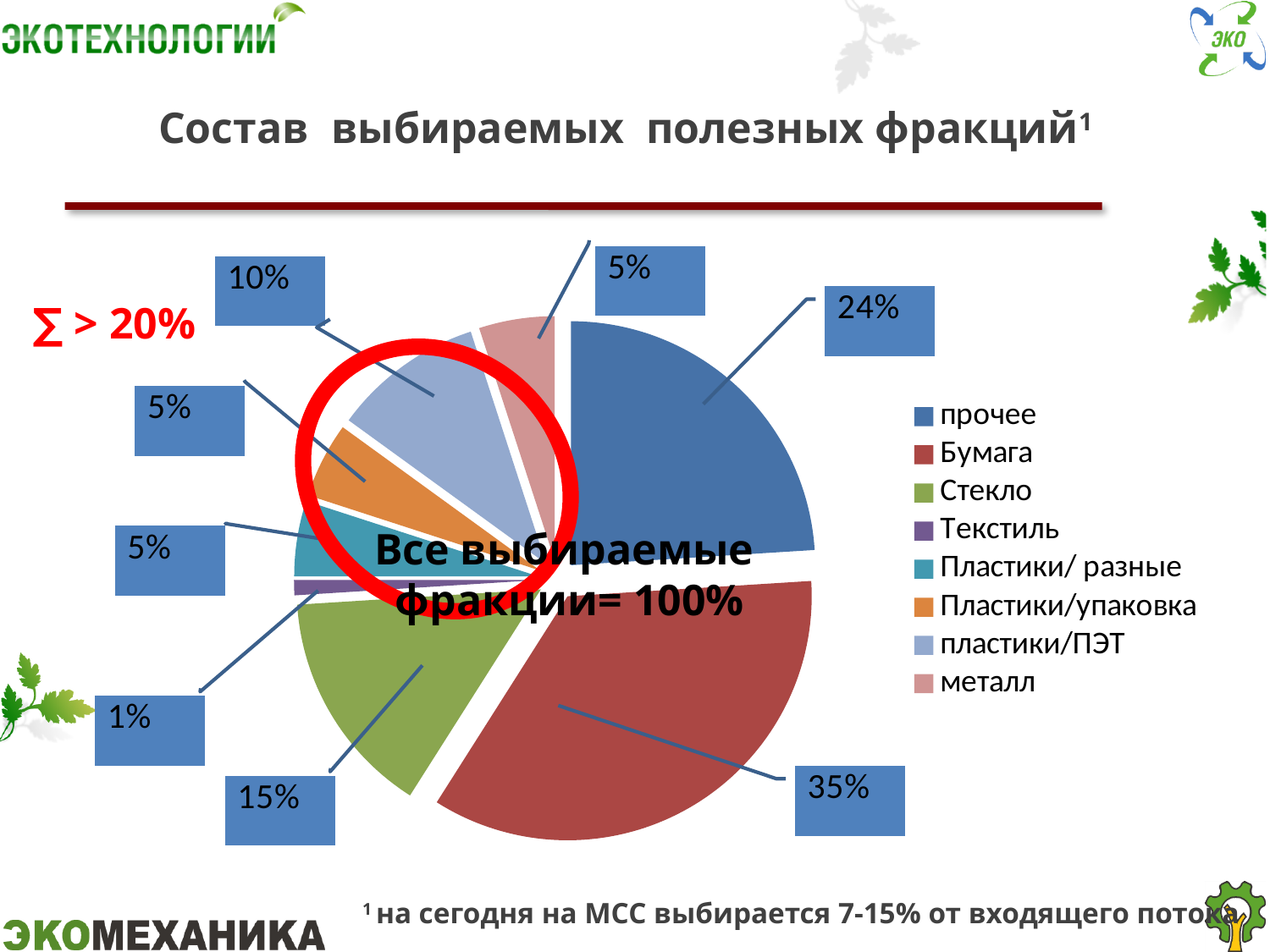
Which is larger, the share of Стекло or the share of пластики/ПЭТ? Стекло How many categories does the legend list? 8 What is the title of the chart on the slide? Состав выбираемых полезных фракций What share of the pie does пластики/ПЭТ have? 10% What share of the pie does Стекло have? 15% What type of chart is shown on the slide? pie chart What share of the pie does Текстиль have? 1% Which category has the largest slice of the pie? Бумага Which category has the smallest slice of the pie? Текстиль What is the difference between the shares of Бумага and прочее? 11% What share of the pie does прочее have? 24% What share of the pie does Бумага have? 35%